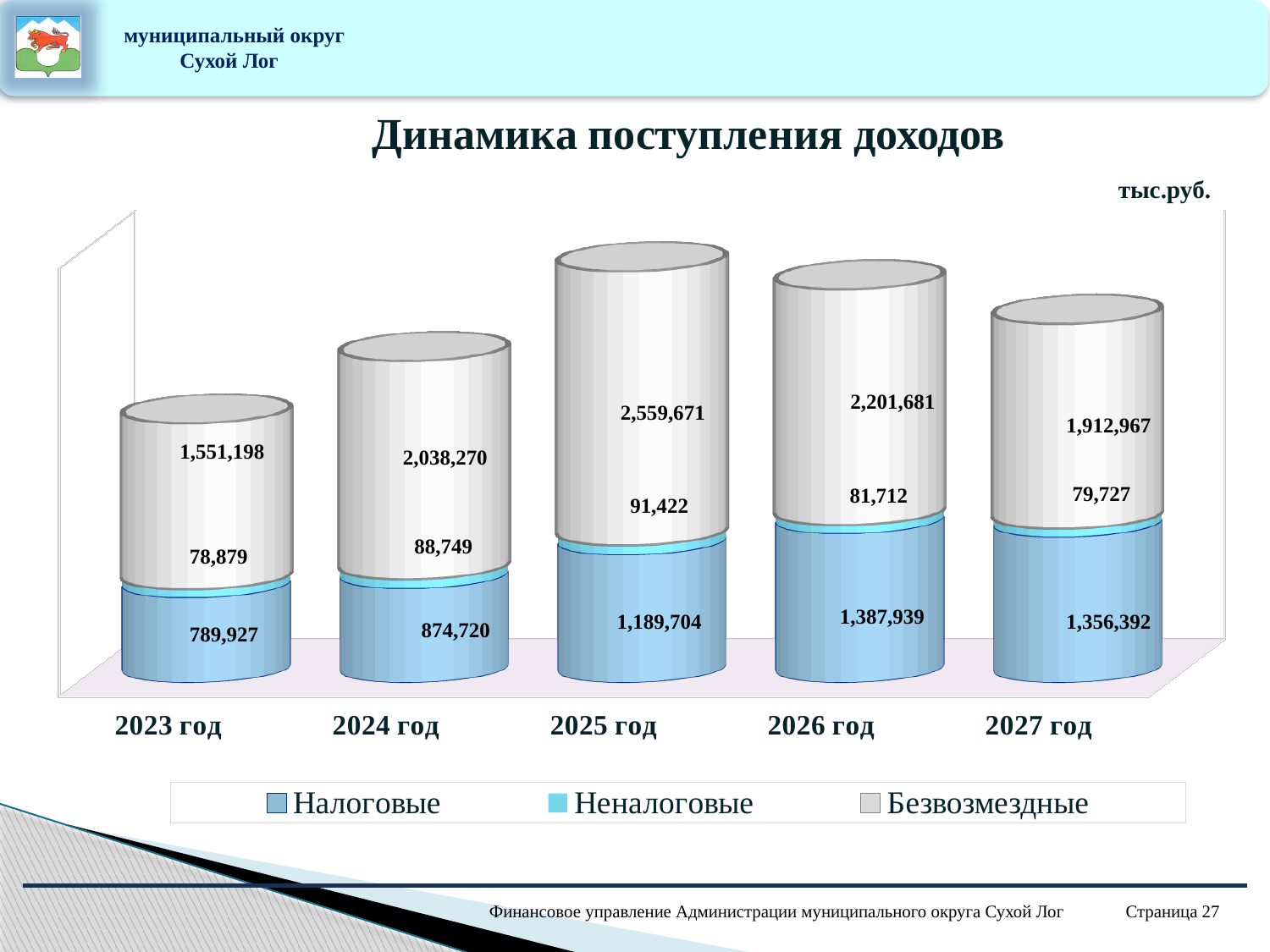
What is the value of Неналоговые for 2024 год? 88,749 What is the value of Налоговые for 2025 год? 1,189,704 What kind of chart is shown on the slide? Stacked bar chart In which year is the Налоговые value the highest? 2026 год In which year is the Неналоговые value the lowest? 2023 год What is the total of the stacked bar for 2023 год? 2,420,004 What is the value of Безвозмездные for 2027 год? 1,912,967 How many years are shown on the x axis? 5 What is the difference between the Безвозмездные values for 2025 год and 2024 год? 521,401 Which is larger: the Налоговые value for 2026 год or for 2027 год? 2026 год How many series does the legend list? 3 In which year is the Безвозмездные value the highest? 2025 год